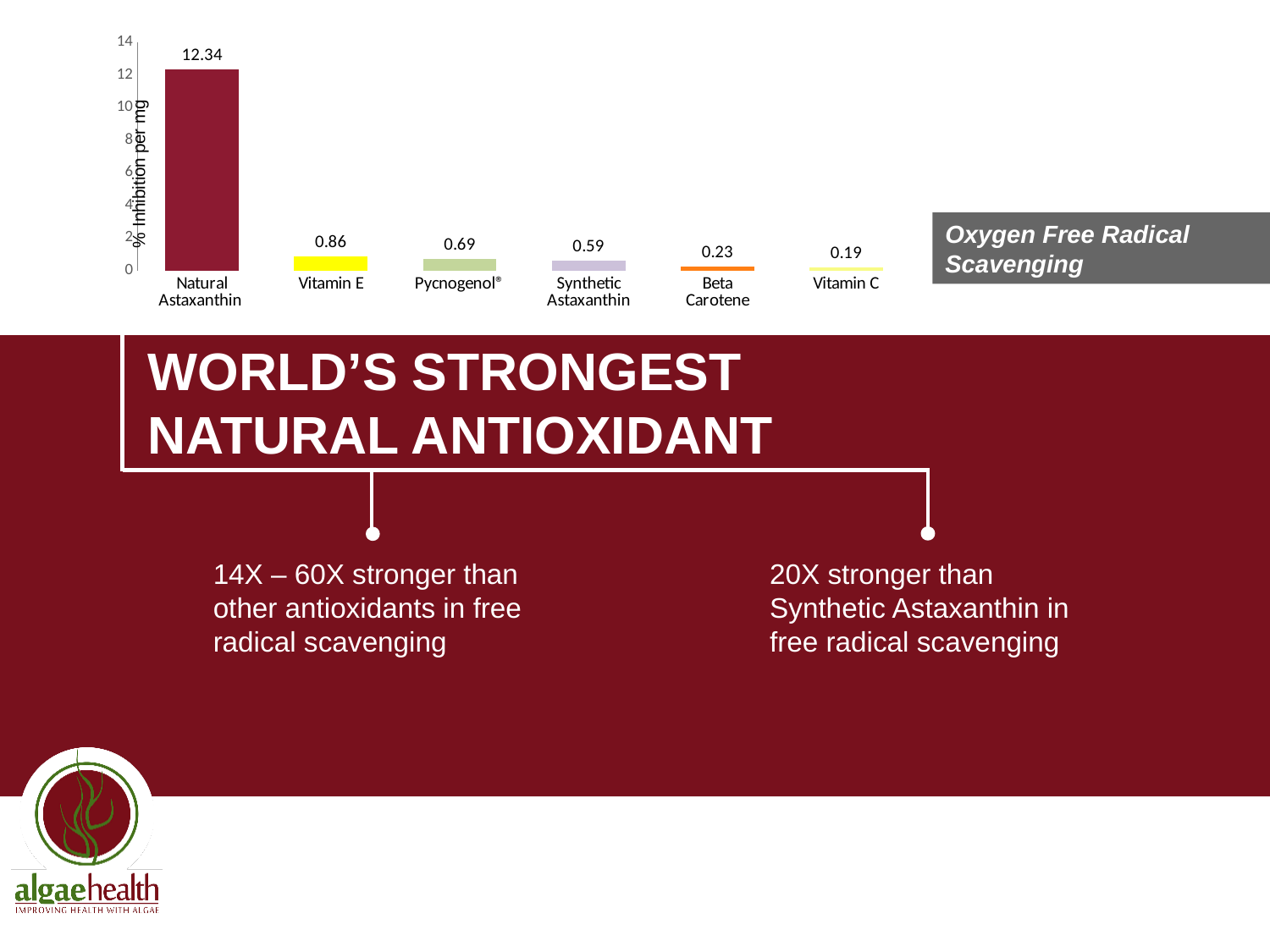
What is the difference between the values for Vitamin E and Pycnogenol®? 0.17 What is the difference between the values for Natural Astaxanthin and Synthetic Astaxanthin? 11.75 Which category has the lowest value? Vitamin C What kind of chart is shown? Bar chart What is the label on the vertical axis? % Inhibition per mg What is the % inhibition per mg value for Natural Astaxanthin? 12.34 What is the value shown for Vitamin E? 0.86 How many categories are shown on the x axis? 6 Which has a larger value, Pycnogenol® or Beta Carotene? Pycnogenol® What is the value shown for Beta Carotene? 0.23 What is the value shown for Synthetic Astaxanthin? 0.59 Which category has the highest value? Natural Astaxanthin